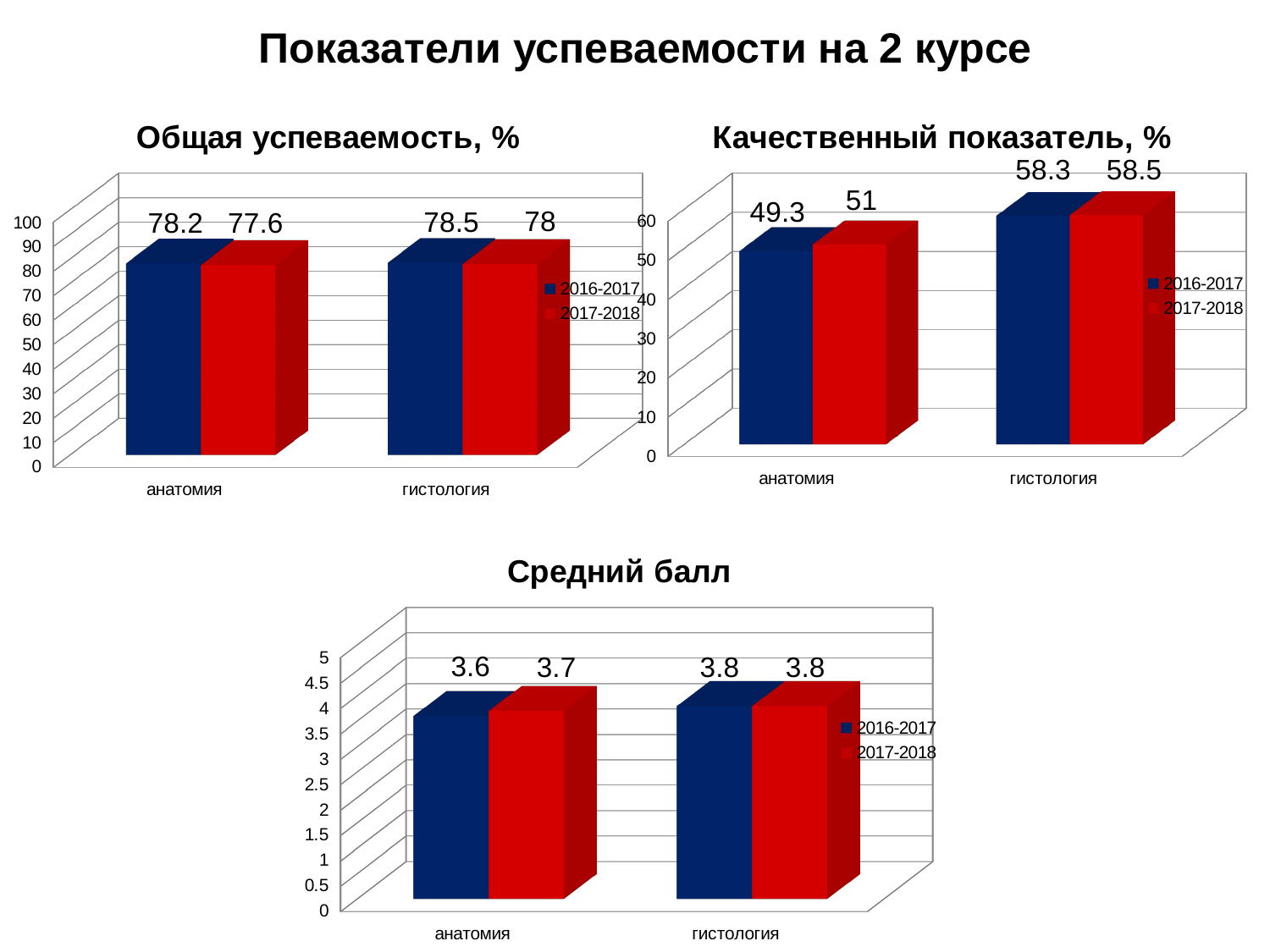
In the chart titled "Общая успеваемость, %", what is the value for гистология in 2017-2018? 78 In the chart titled "Общая успеваемость, %", what is the value for анатомия in 2016-2017? 78.2 In the chart titled "Качественный показатель, %", what is the value for анатомия in 2017-2018? 51 In the chart titled "Средний балл", which is larger for анатомия: the 2016-2017 value or the 2017-2018 value? 2017-2018 In the chart titled "Качественный показатель, %", what is the value for гистология in 2016-2017? 58.3 In the chart titled "Качественный показатель, %", which category has the highest 2017-2018 value? гистология In the chart titled "Средний балл", what is the value for анатомия in 2016-2017? 3.6 How many categories are shown on the x axis of the chart titled "Общая успеваемость, %"? 2 In the chart titled "Общая успеваемость, %", what is the difference between the 2016-2017 and 2017-2018 values for анатомия? 0.6 What kind of chart is the chart titled "Средний балл"? bar chart How many series does the legend list in the chart titled "Средний балл"? 2 In the chart titled "Качественный показатель, %", what is the difference between the 2016-2017 values for гистология and анатомия? 9